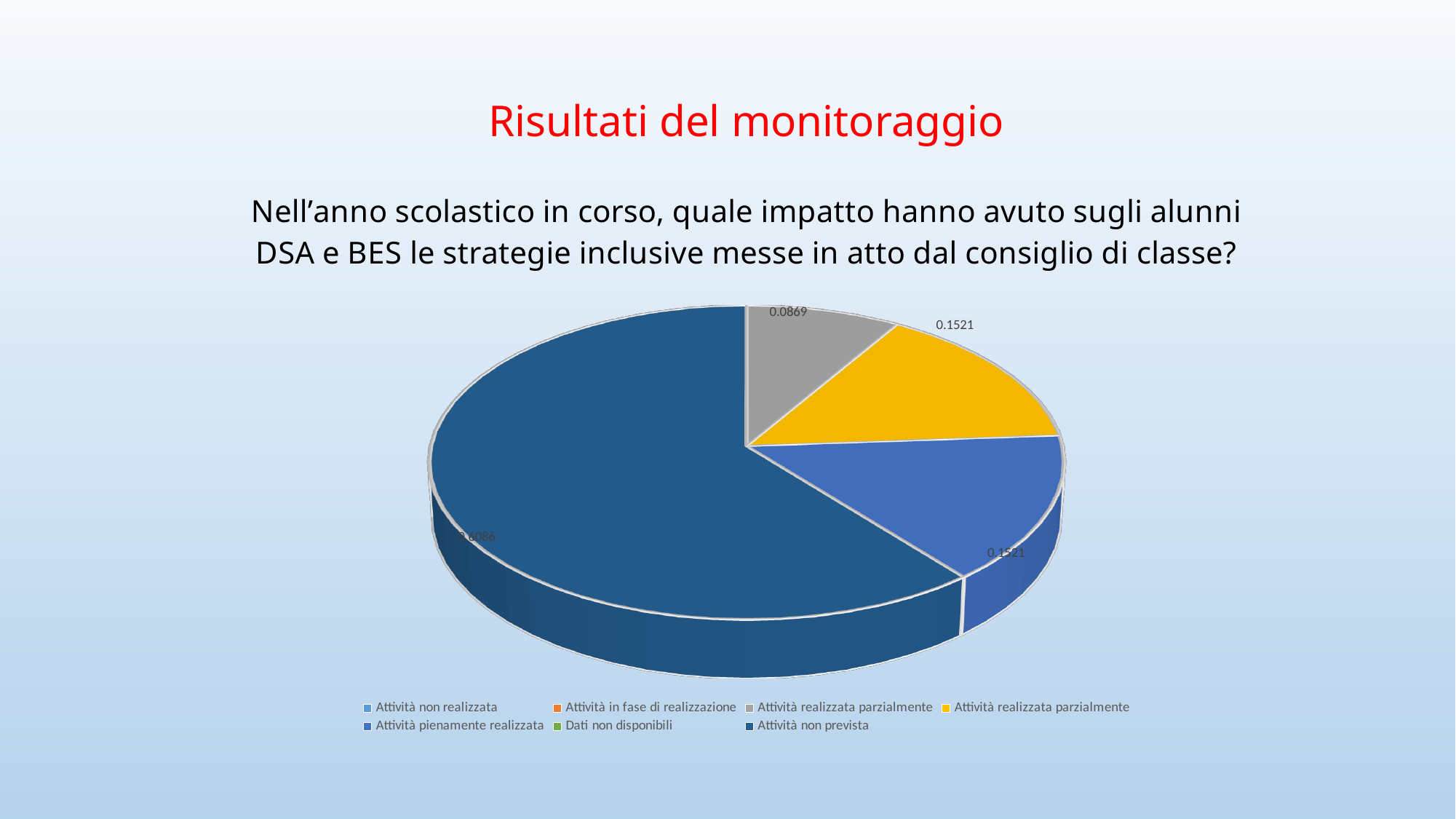
How many entries does the legend list? 7 What is the value labelled on the gray slice of the pie? 0.0869 What is the value labelled for the Attività non prevista slice? 0.6086 Which is larger, the Attività non prevista slice or the Attività pienamente realizzata slice? Attività non prevista Which legend category has the largest slice of the pie? Attività non prevista What is the value labelled for the Attività pienamente realizzata slice? 0.1521 What is the value labelled on the yellow slice of the pie? 0.1521 What is the title of the slide above the chart? Risultati del monitoraggio What is the smallest value labelled on the pie? 0.0869 What is the difference between the yellow slice's value and the gray slice's value? 0.0652 What is the difference between the Attività non prevista value and the Attività pienamente realizzata value? 0.4565 What kind of chart is shown on the slide? pie chart